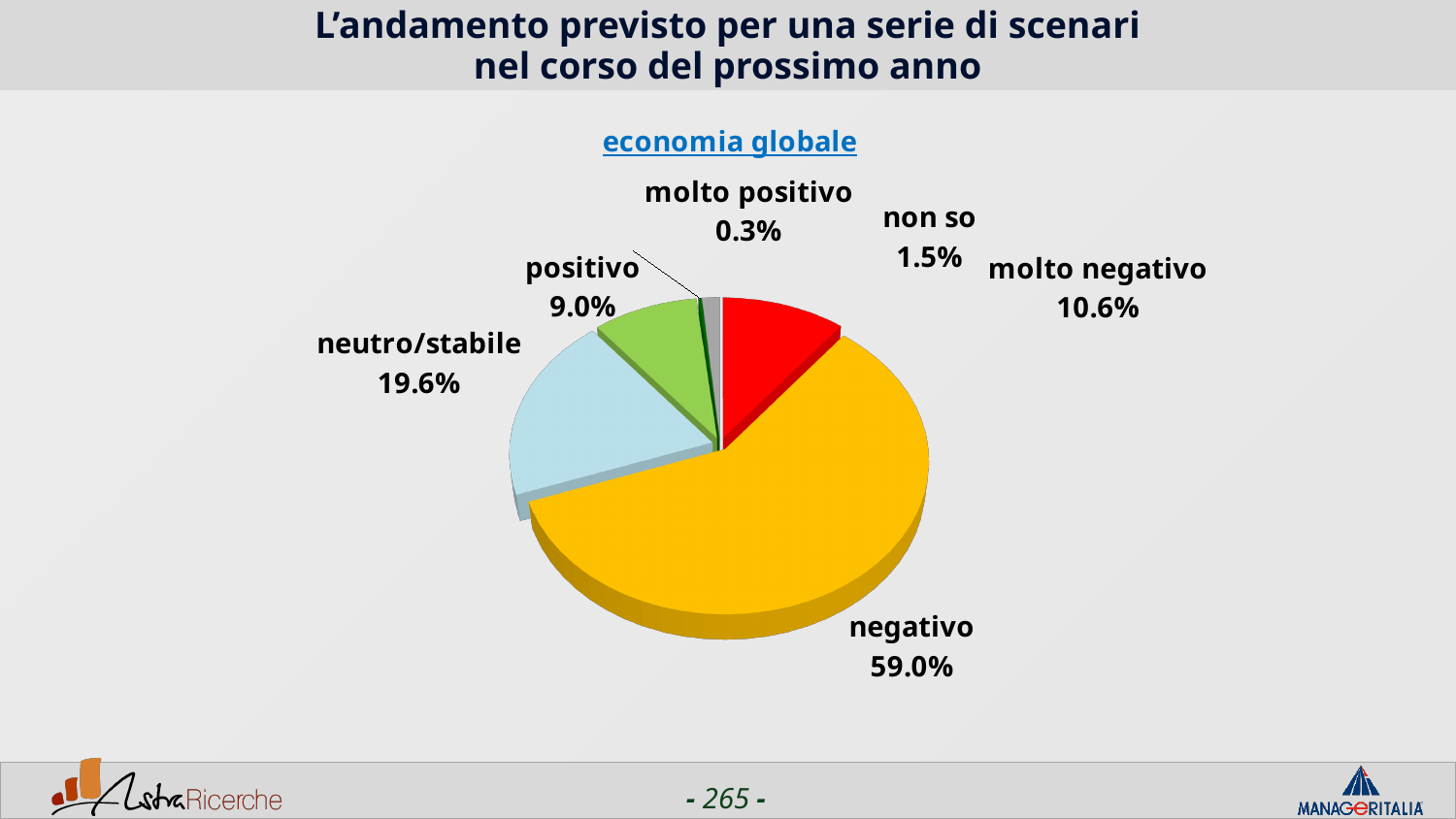
Which category has the largest share of the pie? negativo Which category has the smallest share of the pie? molto positivo What is the value for "non so"? 1.5% What is the value for "negativo"? 59.0% What is the value for "molto negativo"? 10.6% What is the difference between the values for "negativo" and "neutro/stabile"? 39.4% Which is larger, the value for "positivo" or the value for "molto negativo"? molto negativo What is the value for "neutro/stabile"? 19.6% How many slices does the pie chart have? 6 What is the subtitle shown above the pie chart? economia globale What colour is the "negativo" slice? yellow What kind of chart is shown on the slide? pie chart